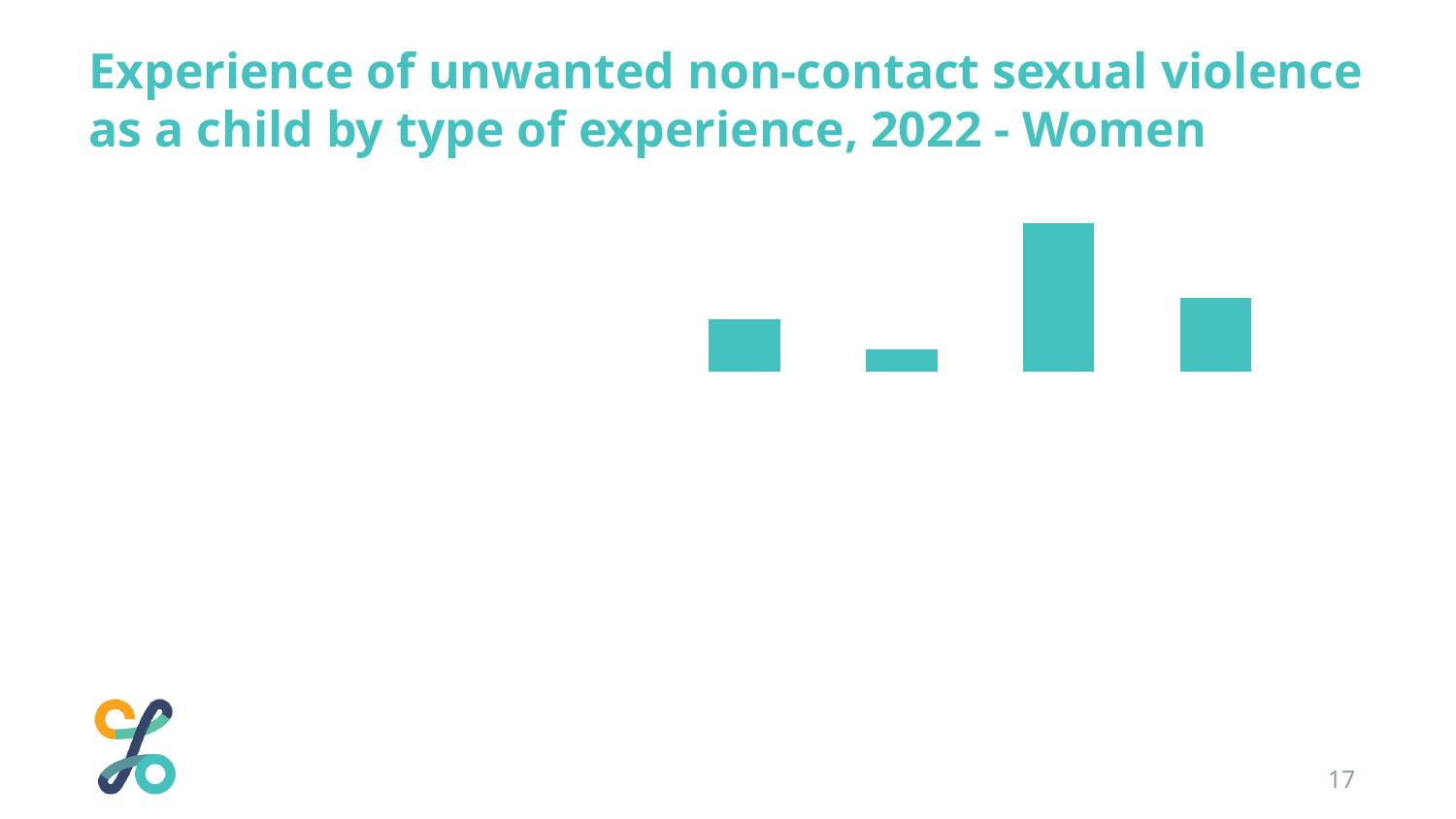
What year does the chart title refer to? 2022 Which bar is the tallest in the chart, counting from the left? The third bar Which is taller, the first bar from the left or the fourth bar from the left? The fourth bar Which is taller, the first bar from the left or the second bar from the left? The first bar Which is taller, the second bar from the left or the third bar from the left? The third bar What kind of chart is shown on the slide? Bar chart How many bars does the chart contain? 4 What colour are the bars in the chart? Teal Which bar is the shortest in the chart, counting from the left? The second bar